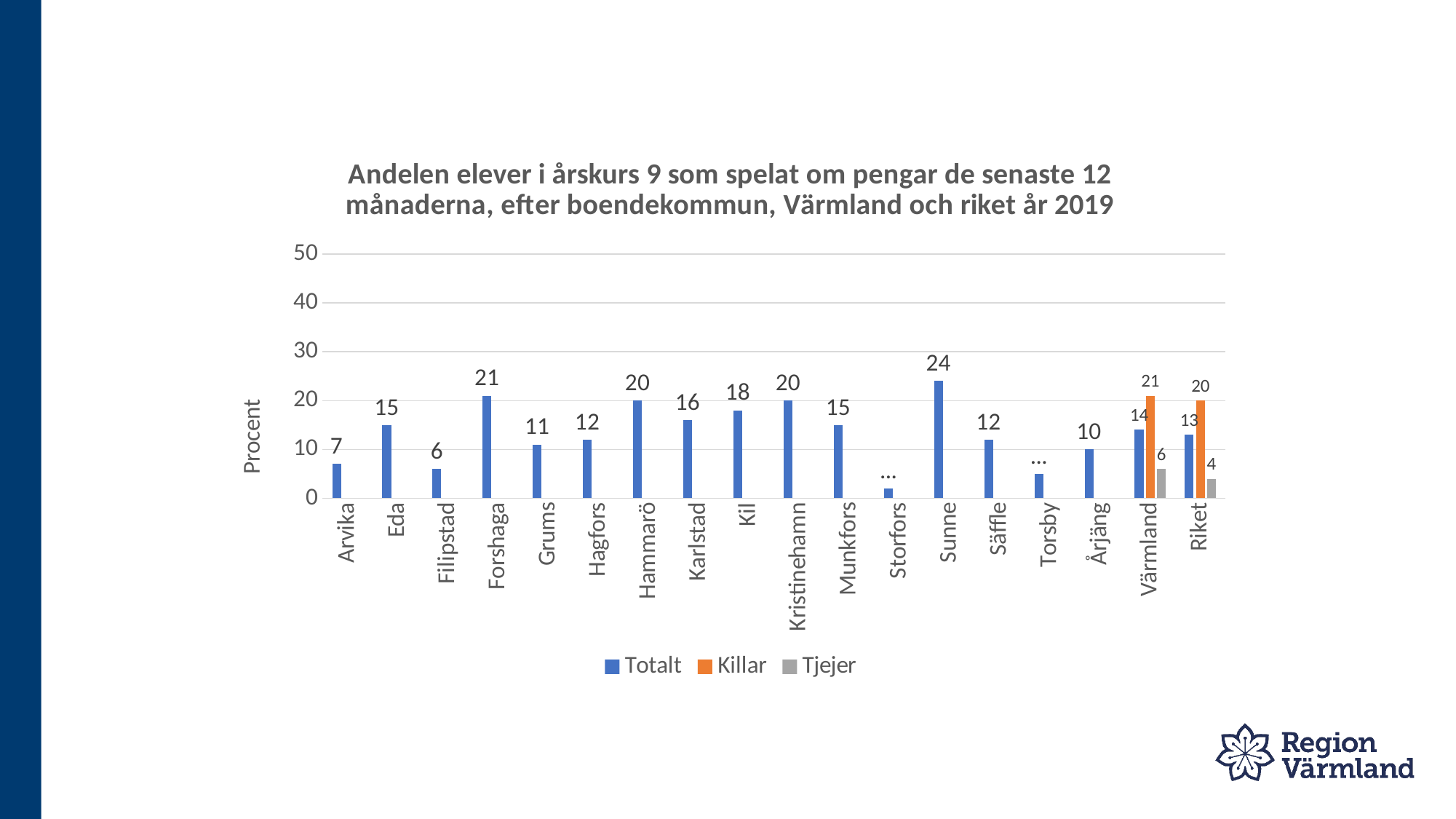
What kind of chart is shown on the slide? bar chart What is the difference between the Killar and Tjejer values for Värmland? 15 How many series does the legend list? 3 What is the label on the y axis? Procent What is the Killar value for Värmland? 21 Which category has the highest Totalt value? Sunne Is the Totalt value for Storfors greater or less than 10? less What is the Totalt value for Sunne? 24 How many categories are shown on the x axis? 18 What is the Tjejer value for Riket? 4 What is the Totalt value for Forshaga? 21 Which has a higher Totalt value, Kil or Karlstad? Kil